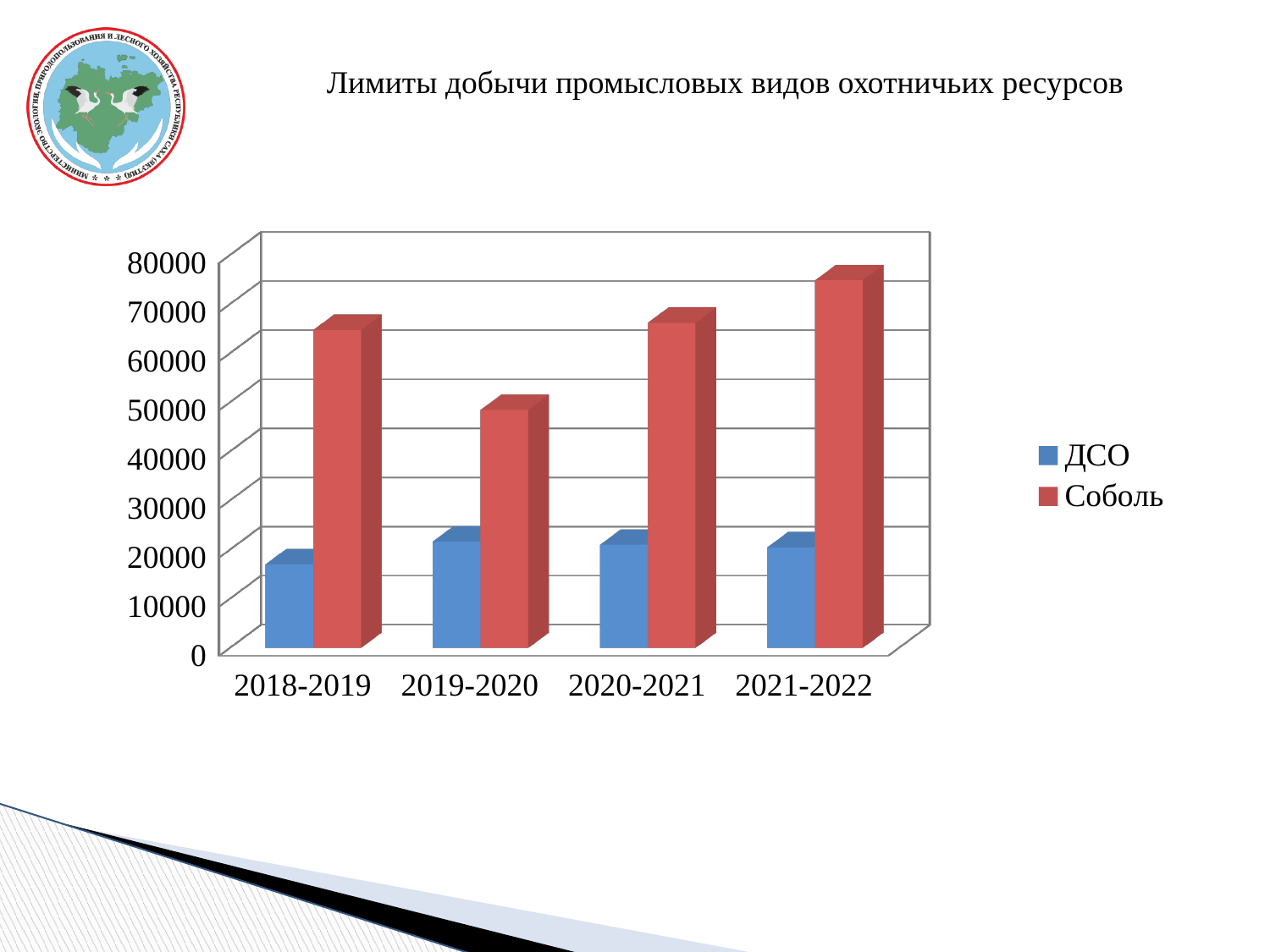
In which season is the value for Соболь the lowest? 2019-2020 What is the title of the chart? Лимиты добычи промысловых видов охотничьих ресурсов How many series does the legend list? 2 Which series is shown in red? Соболь Is the value for Соболь in 2019-2020 greater or less than 60000? less Which is larger: the value for Соболь in 2021-2022 or in 2018-2019? 2021-2022 Which is larger: the value for ДСО in 2018-2019 or in 2019-2020? 2019-2020 What kind of chart is shown on the slide? bar chart How many seasons (categories) are shown on the x axis? 4 In which season is the value for Соболь the highest? 2021-2022 Is the value for Соболь in 2021-2022 greater or less than 70000? greater Is the value for ДСО in 2018-2019 greater or less than 20000? less